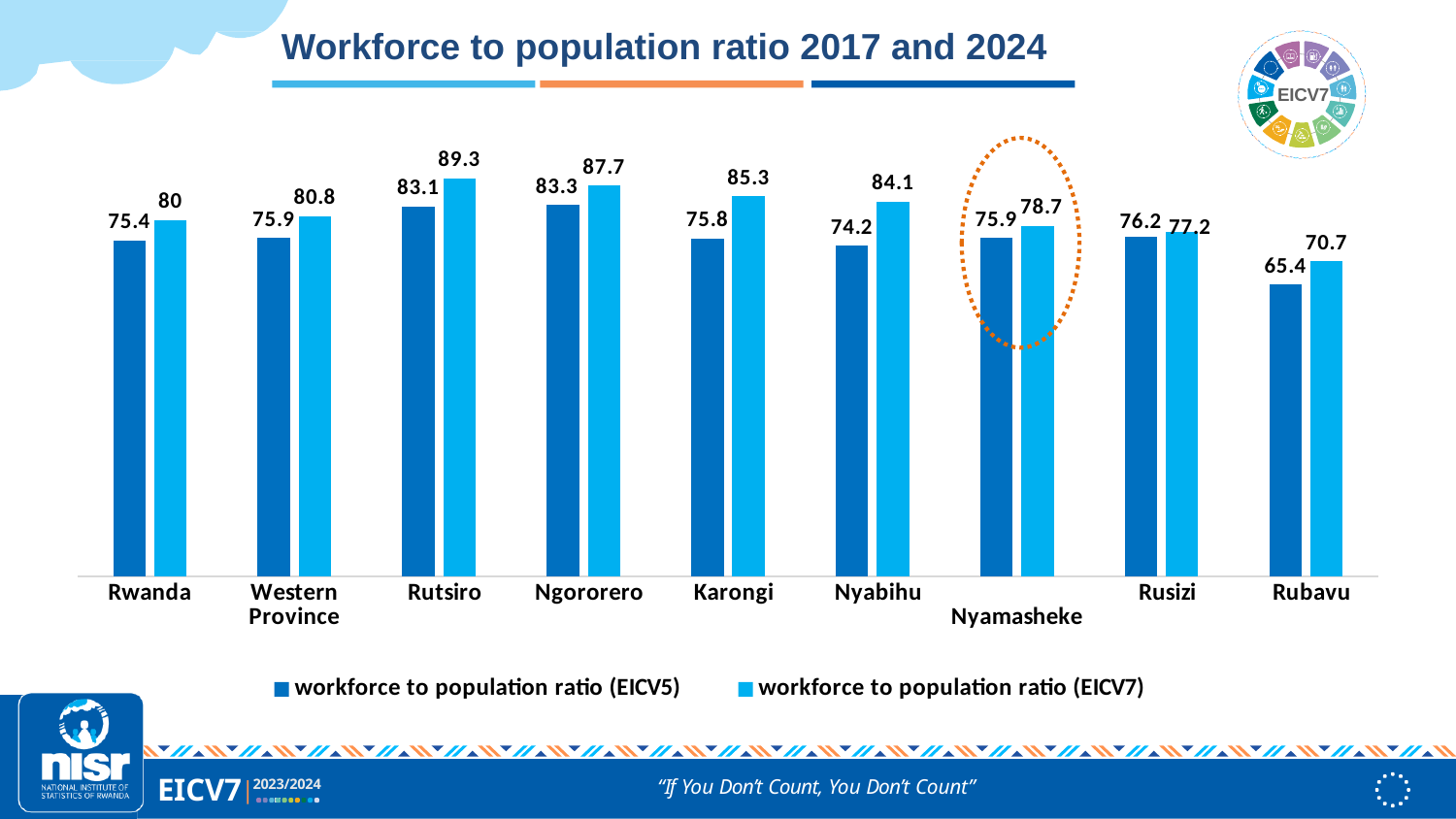
What is the workforce to population ratio (EICV7) for Rutsiro? 89.3 Which category has the highest workforce to population ratio (EICV7)? Rutsiro How many series does the legend list? 2 Which category has the lowest workforce to population ratio (EICV5)? Rubavu Which category is highlighted with a dotted orange circle? Nyamasheke What kind of chart is shown on the slide? Bar chart How many categories are shown on the x axis of the chart? 9 What is the difference between the EICV7 and EICV5 workforce to population ratio for Karongi? 9.5 What is the workforce to population ratio (EICV7) for Rwanda? 80 What is the title of the chart? Workforce to population ratio 2017 and 2024 Which is larger: the EICV5 workforce to population ratio for Ngororero or for Rutsiro? Ngororero What is the workforce to population ratio (EICV5) for Nyabihu? 74.2